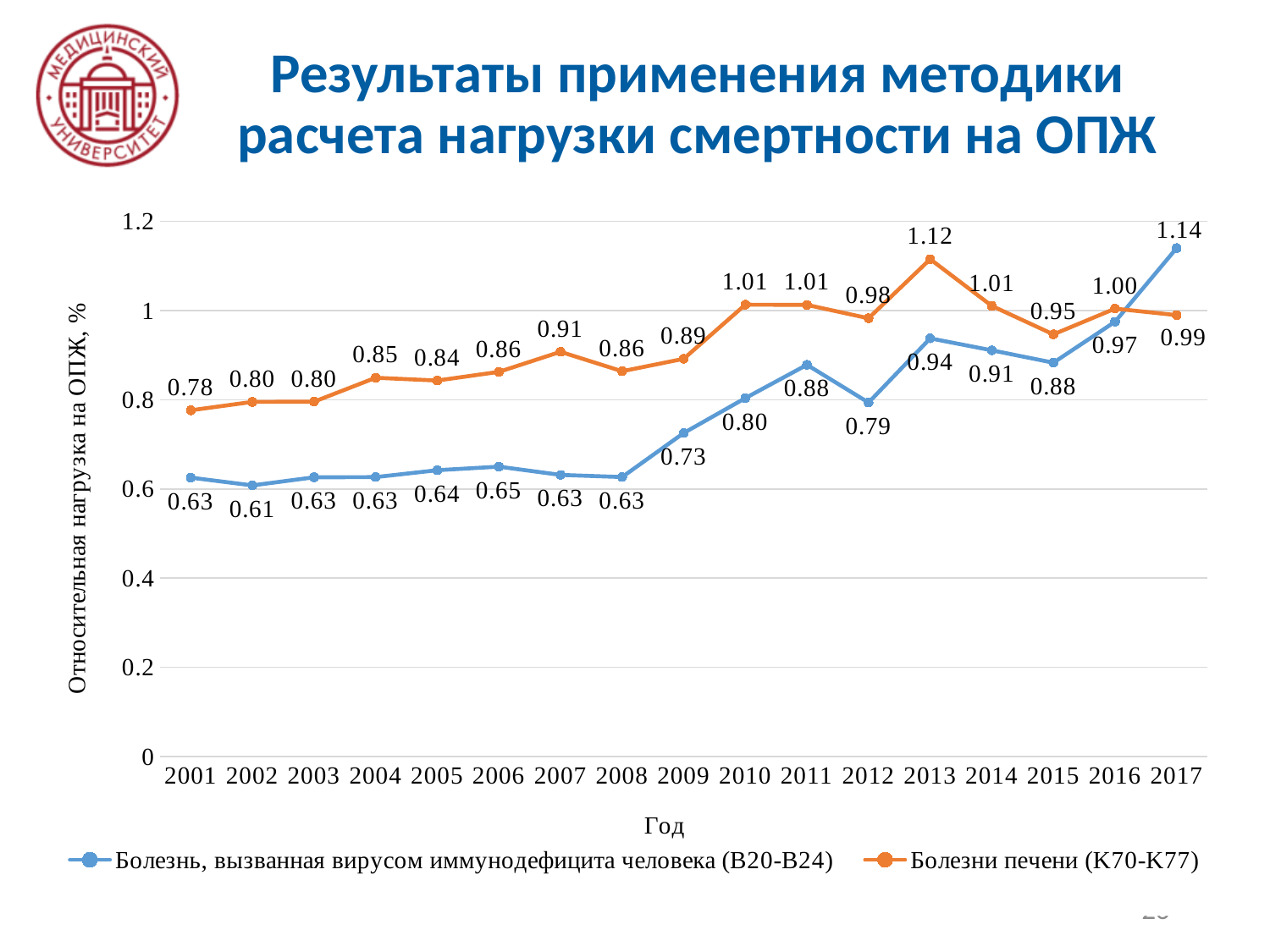
What is the value for Болезни печени (K70-K77) in 2013? 1.12 What type of chart is shown on the slide? line chart In 2017, which series has the larger value: Болезнь, вызванная вирусом иммунодефицита человека (B20-B24) or Болезни печени (K70-K77)? Болезнь, вызванная вирусом иммунодефицита человека (B20-B24) What is the difference between the Болезни печени (K70-K77) value and the Болезнь, вызванная вирусом иммунодефицита человека (B20-B24) value in 2001? 0.15 What is the value for Болезнь, вызванная вирусом иммунодефицита человека (B20-B24) in 2002? 0.61 Does the value for Болезнь, вызванная вирусом иммунодефицита человека (B20-B24) generally rise or fall from 2008 to 2017? rise What is the label of the y axis? Относительная нагрузка на ОПЖ, % How many years are shown on the x axis? 17 In which year is the value for Болезни печени (K70-K77) highest? 2013 In which year is the value for Болезнь, вызванная вирусом иммунодефицита человека (B20-B24) lowest? 2002 How many series does the legend list? 2 What is the value for Болезнь, вызванная вирусом иммунодефицита человека (B20-B24) in 2017? 1.14